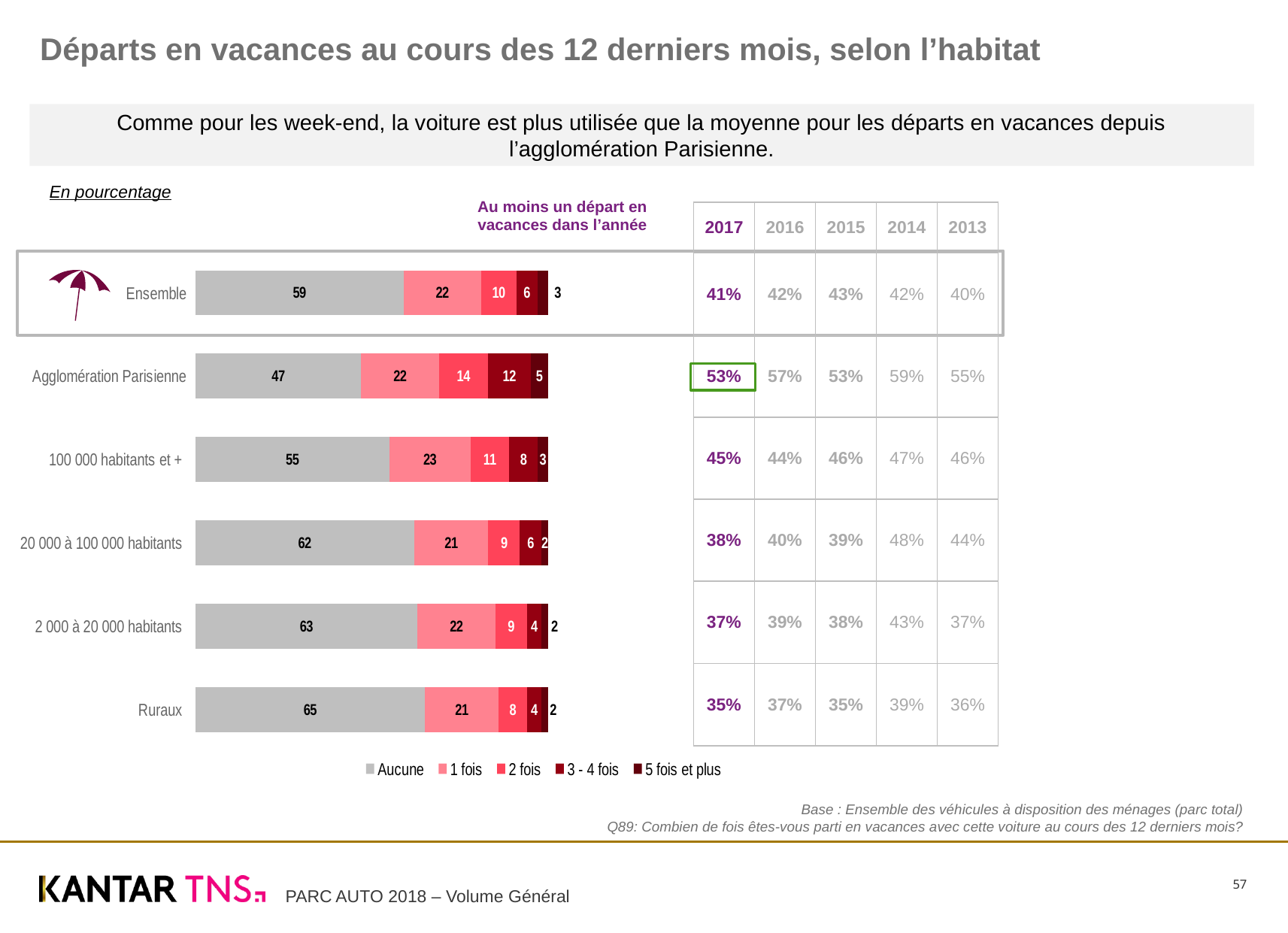
What is the difference between the "Aucune" values for Ruraux and Agglomération Parisienne? 18 What kind of chart is shown on the slide? Stacked bar chart How many categories are shown in the bar chart? 6 Which is larger: the "2 fois" value for Agglomération Parisienne or for Ensemble? Agglomération Parisienne Which category has the lowest value for "Aucune"? Agglomération Parisienne What is the total of the stacked bar for Ensemble? 100 How many series does the legend list? 5 What is the value for "3 - 4 fois" for Agglomération Parisienne? 12 Which legend entry is shown in grey? Aucune What is the value for "Aucune" for Ruraux? 65 Which category has the highest value for "Aucune"? Ruraux What is the value for "1 fois" for 100 000 habitants et +? 23